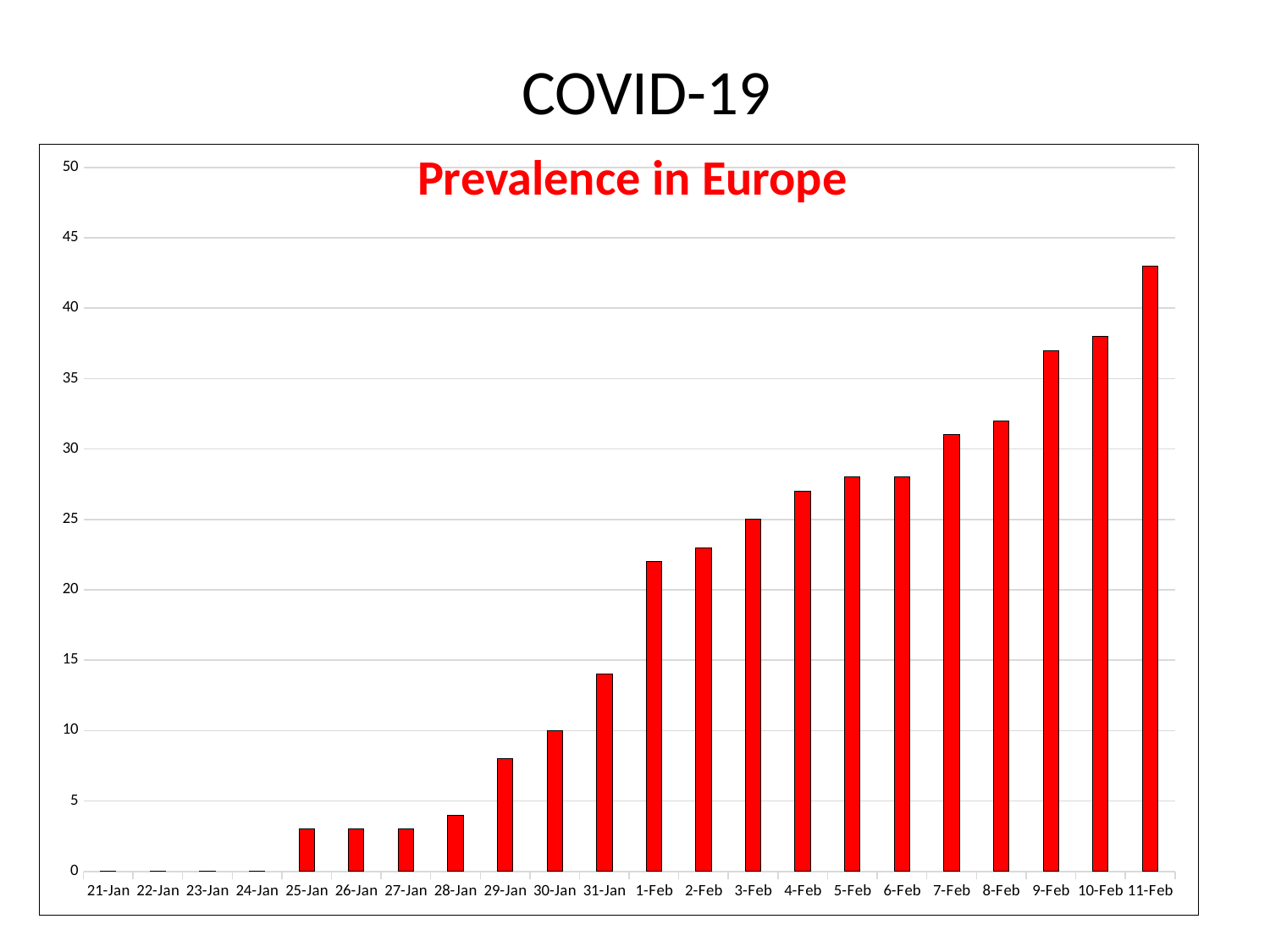
What is the title of the chart? Prevalence in Europe Which is larger, the value for 31-Jan or the value for 3-Feb? 3-Feb Is the value for 7-Feb greater or less than 30? greater Is the value for 11-Feb greater or less than 40? greater Do the values generally rise or fall from 21-Jan to 11-Feb? rise Which is larger, the value for 9-Feb or the value for 5-Feb? 9-Feb How many dates are plotted along the x axis? 22 Which date has the highest value? 11-Feb What colour are the bars in the chart? red Is the value for 31-Jan greater or less than 15? less What kind of chart is shown on the slide? bar chart